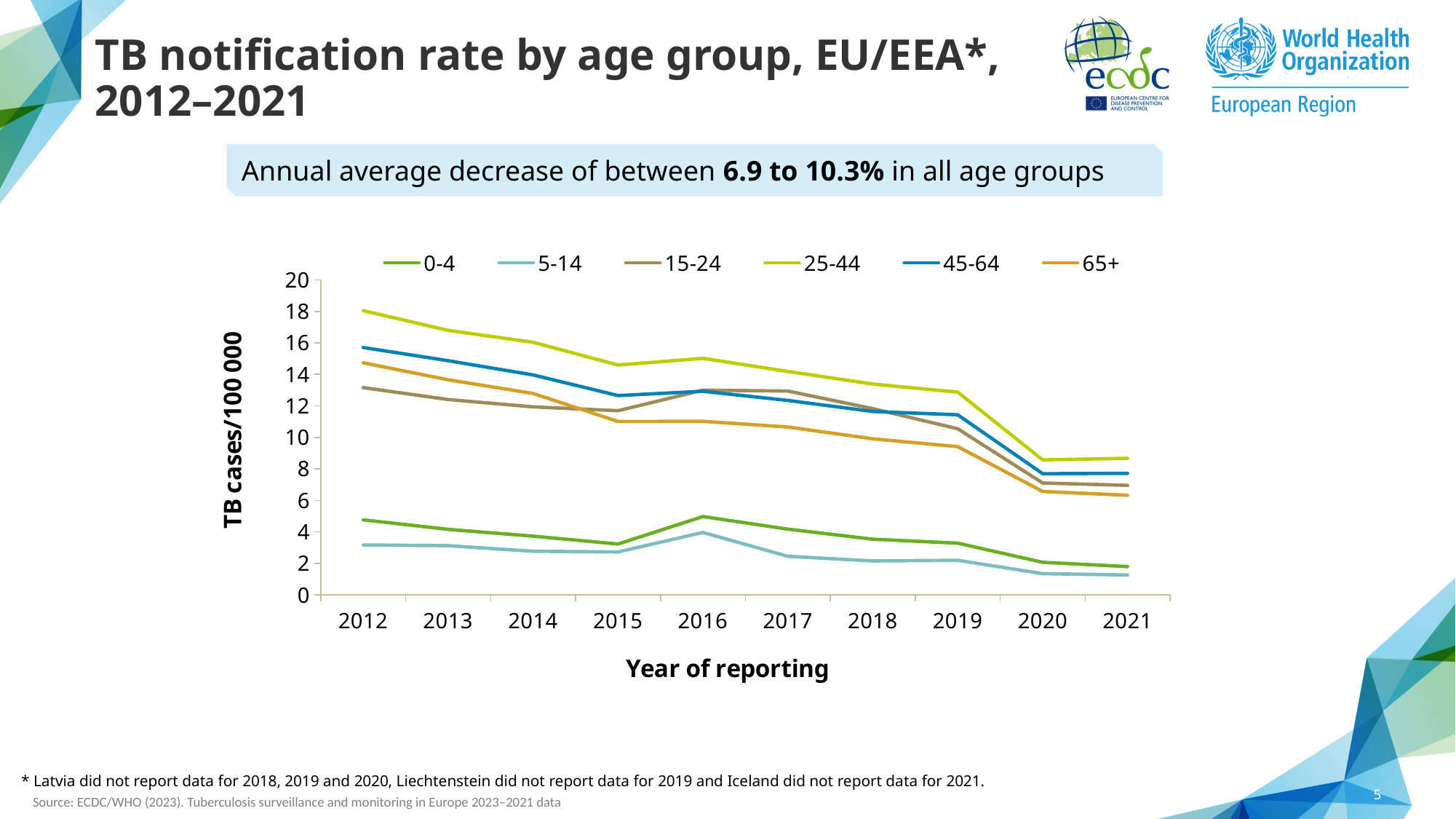
Is the value for the 5-14 age group in 2021 greater or less than 2? less What is the title of the y axis? TB cases/100 000 Is the value for the 25-44 age group in 2012 greater or less than 16? greater Is the value for the 45-64 age group in 2021 greater or less than 8? less Does the TB notification rate for the 25-44 age group rise or fall from 2012 to 2021? fall Which age group has the lowest TB notification rate in 2021? 5-14 Which age group has the highest TB notification rate in 2012? 25-44 How many years of reporting are shown on the x axis? 10 How many age groups does the legend list? 6 What kind of chart is shown on the slide? line chart In 2012, which age group has the higher TB notification rate, 45-64 or 65+? 45-64